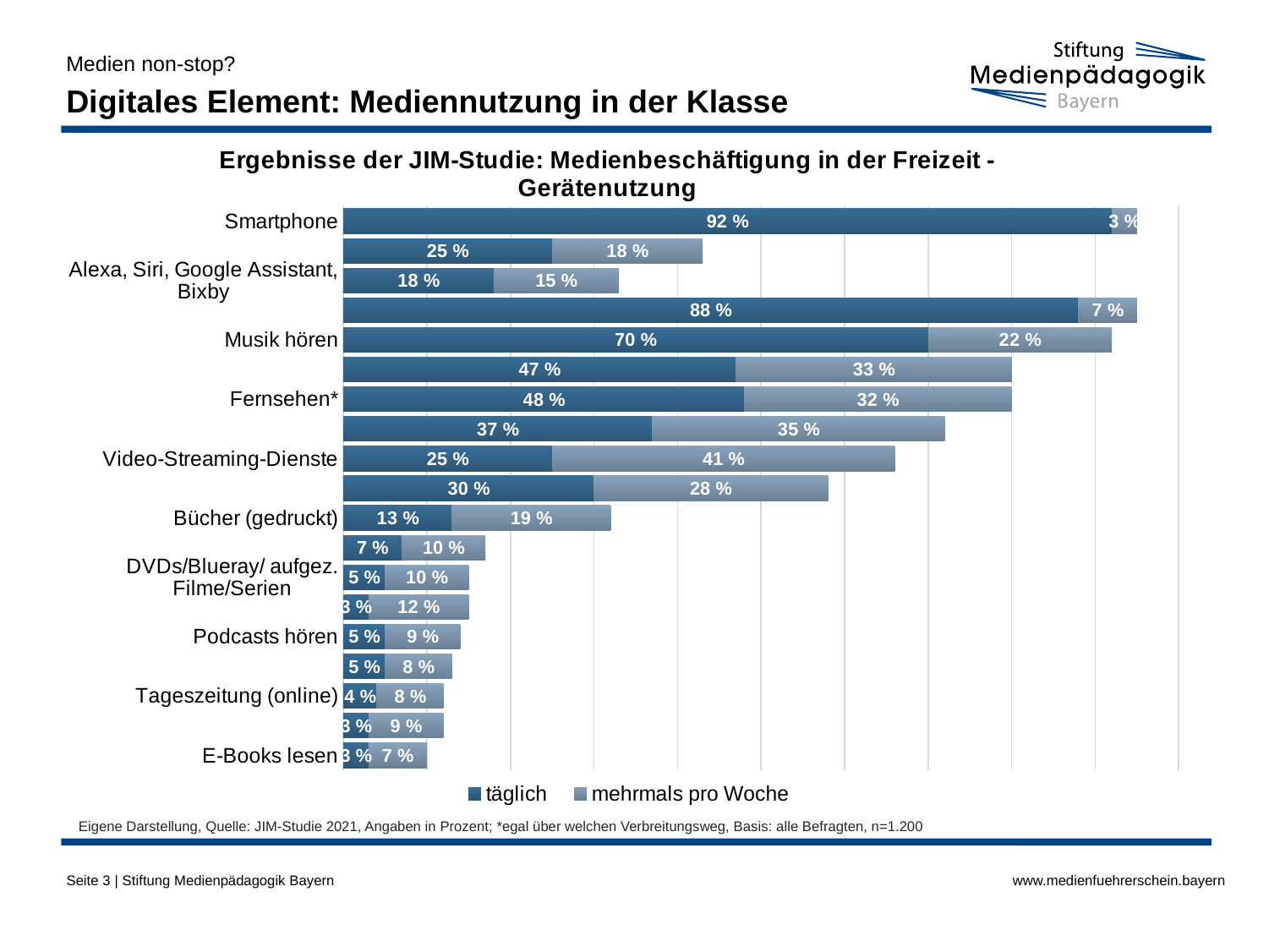
What is the 'mehrmals pro Woche' value for Video-Streaming-Dienste? 41 % What are the two series named in the legend? täglich, mehrmals pro Woche Which category has the highest 'täglich' value? Smartphone What is the 'mehrmals pro Woche' value for Musik hören? 22 % For Video-Streaming-Dienste, which is larger: the 'täglich' value or the 'mehrmals pro Woche' value? mehrmals pro Woche What is the total of the stacked bar for Bücher (gedruckt)? 32 % What is the total of the stacked bar for Fernsehen*? 80 % How many series does the legend list? 2 What is the 'täglich' value for Smartphone? 92 % What is the difference between the 'täglich' and 'mehrmals pro Woche' values for Musik hören? 48 % What is the 'täglich' value for Fernsehen*? 48 % What kind of chart is shown on the slide? bar chart